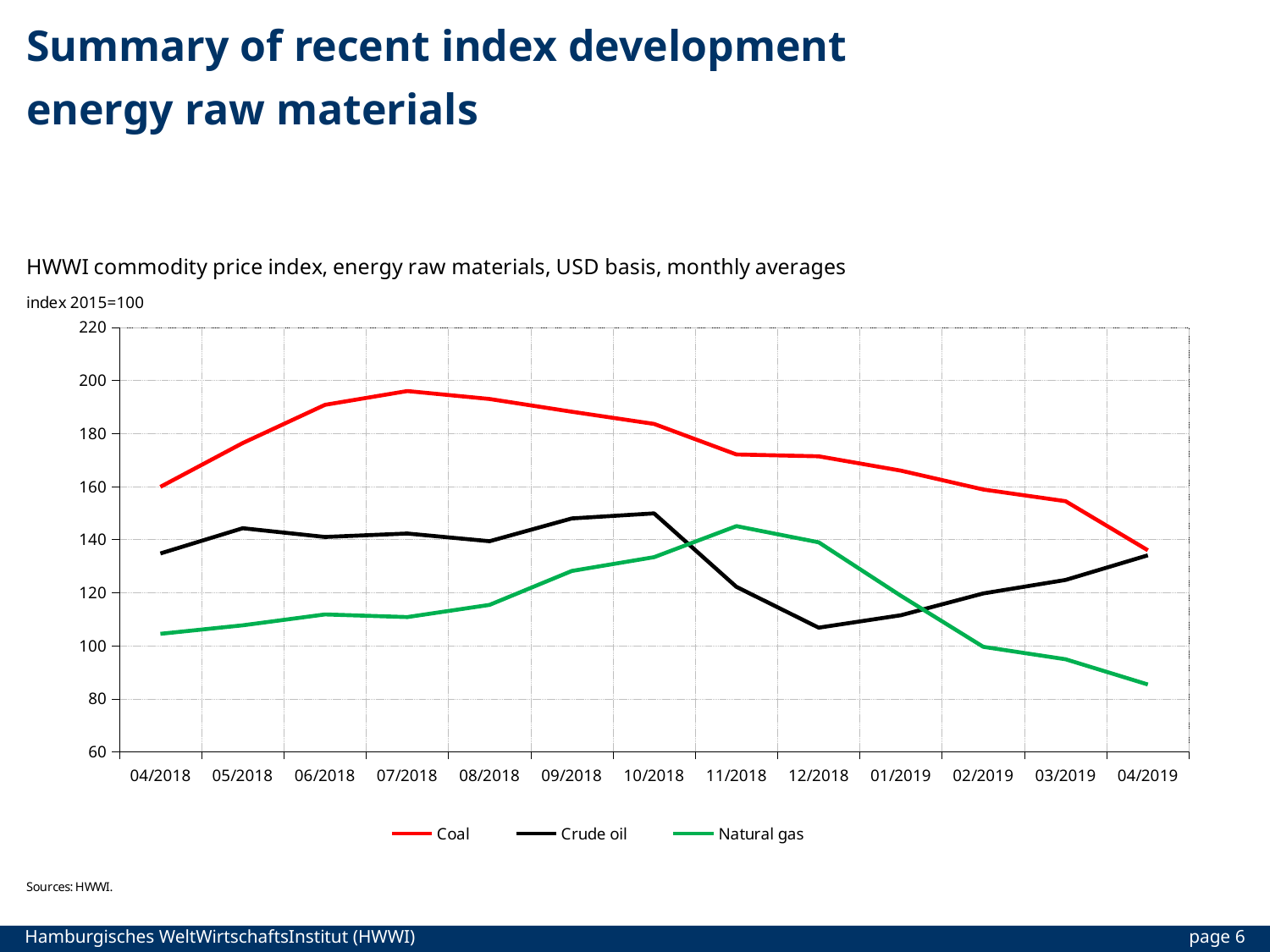
In which month does the Coal index reach its highest value? 07/2018 Is the value for Natural gas in 04/2019 greater or less than 100? less In which month is the Natural gas index at its lowest? 04/2019 How many series does the legend list? 3 How many months are plotted along the x axis? 13 Which colour is used for the Natural gas line in the legend? Green Is the value for Coal in 07/2018 greater or less than 180? greater What kind of chart is shown on the slide? Line chart In which month is the Crude oil index at its lowest? 12/2018 Is the value for Crude oil in 12/2018 greater or less than 120? less Does the Natural gas index rise or fall from 11/2018 to 04/2019? Fall Which series has the higher value in 12/2018, Crude oil or Natural gas? Natural gas